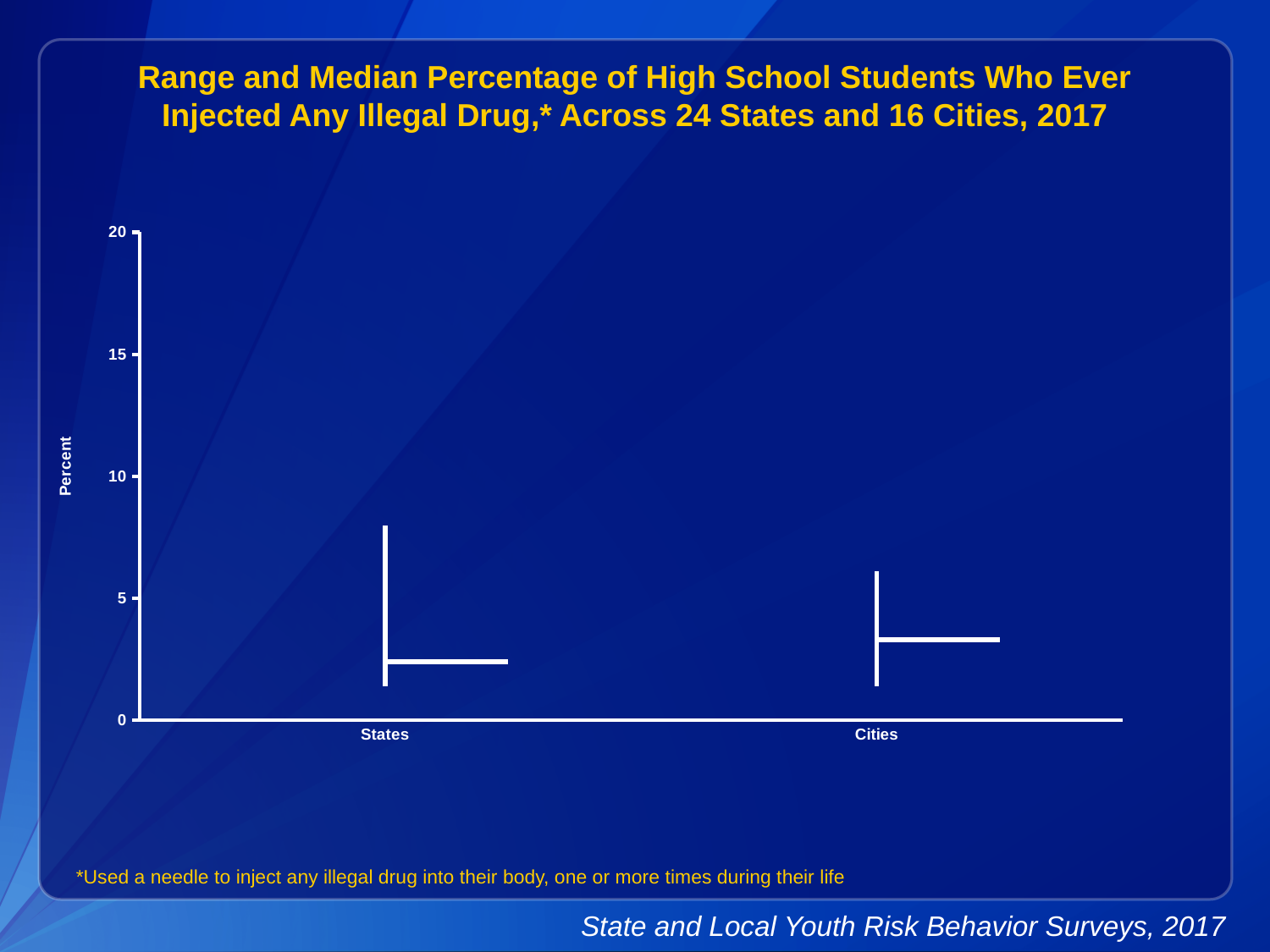
How many categories are shown on the horizontal axis? 2 Which category has the higher median, States or Cities? Cities What are the two categories shown on the horizontal axis? States and Cities What is the highest value shown on the vertical axis? 20 Is the median value for Cities greater or less than 5? less What is the label on the vertical axis? Percent Is the top of the range for States greater or less than 10? less Which category has the higher top of its range, States or Cities? States Is the median value for States greater or less than 5? less What is the title of the chart? Range and Median Percentage of High School Students Who Ever Injected Any Illegal Drug,* Across 24 States and 16 Cities, 2017